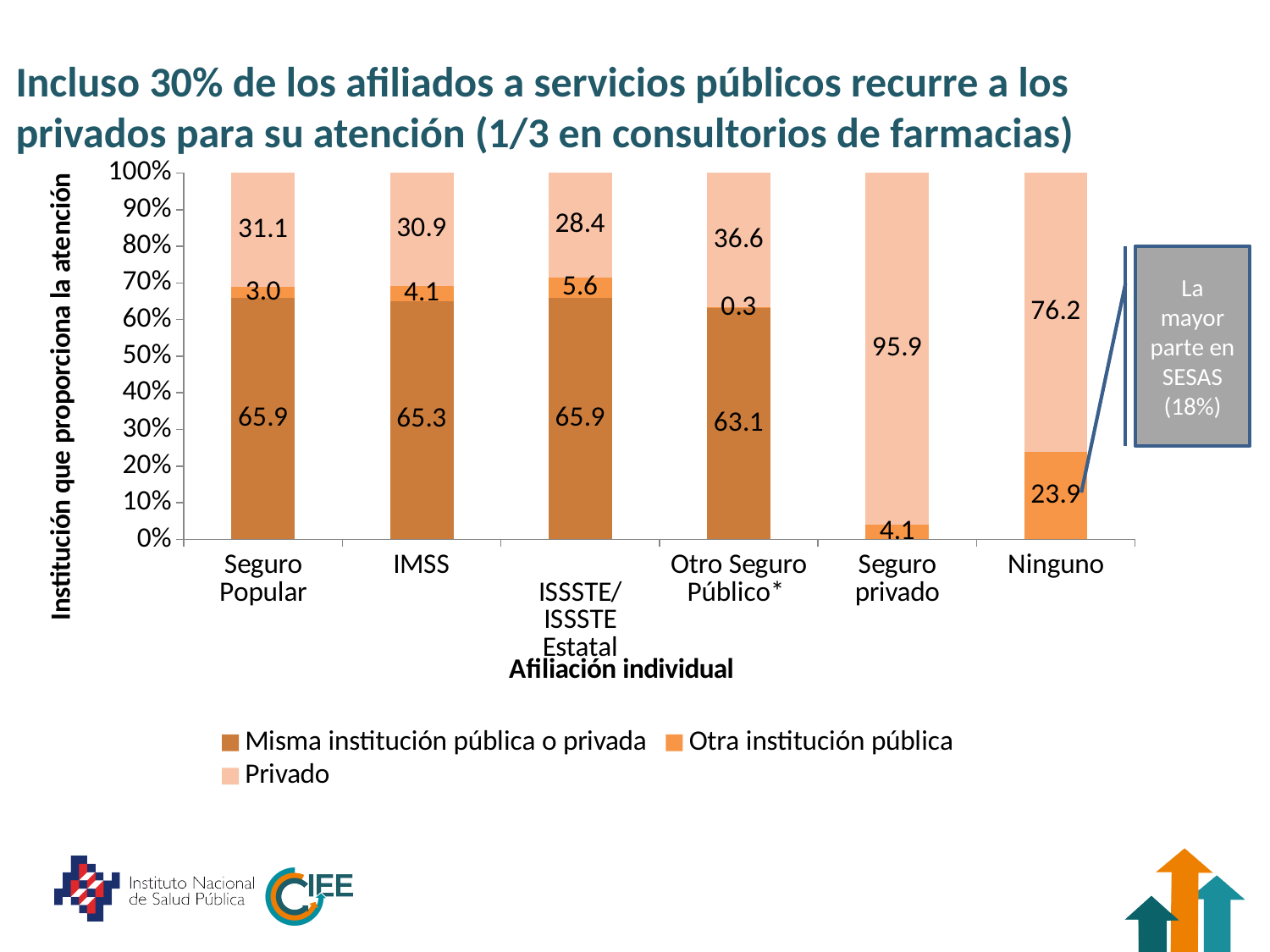
What is the value of 'Privado' for Seguro Popular? 31.1 What is the value of 'Otra institución pública' for IMSS? 4.1 What is the difference between the 'Privado' values for Otro Seguro Público* and ISSSTE/ISSSTE Estatal? 8.2 What is the value of 'Privado' for Seguro privado? 95.9 How many categories are shown on the x axis? 6 What kind of chart is shown on the slide? Stacked bar chart What is the value of 'Otra institución pública' for Ninguno? 23.9 What is the value of 'Misma institución pública o privada' for Otro Seguro Público*? 63.1 How many series does the legend list? 3 Which category has the lowest value for 'Otra institución pública' among those with a printed label? Otro Seguro Público* Which is larger, the 'Misma institución pública o privada' value for IMSS or for Seguro Popular? Seguro Popular Which category has the highest value for 'Privado'? Seguro privado